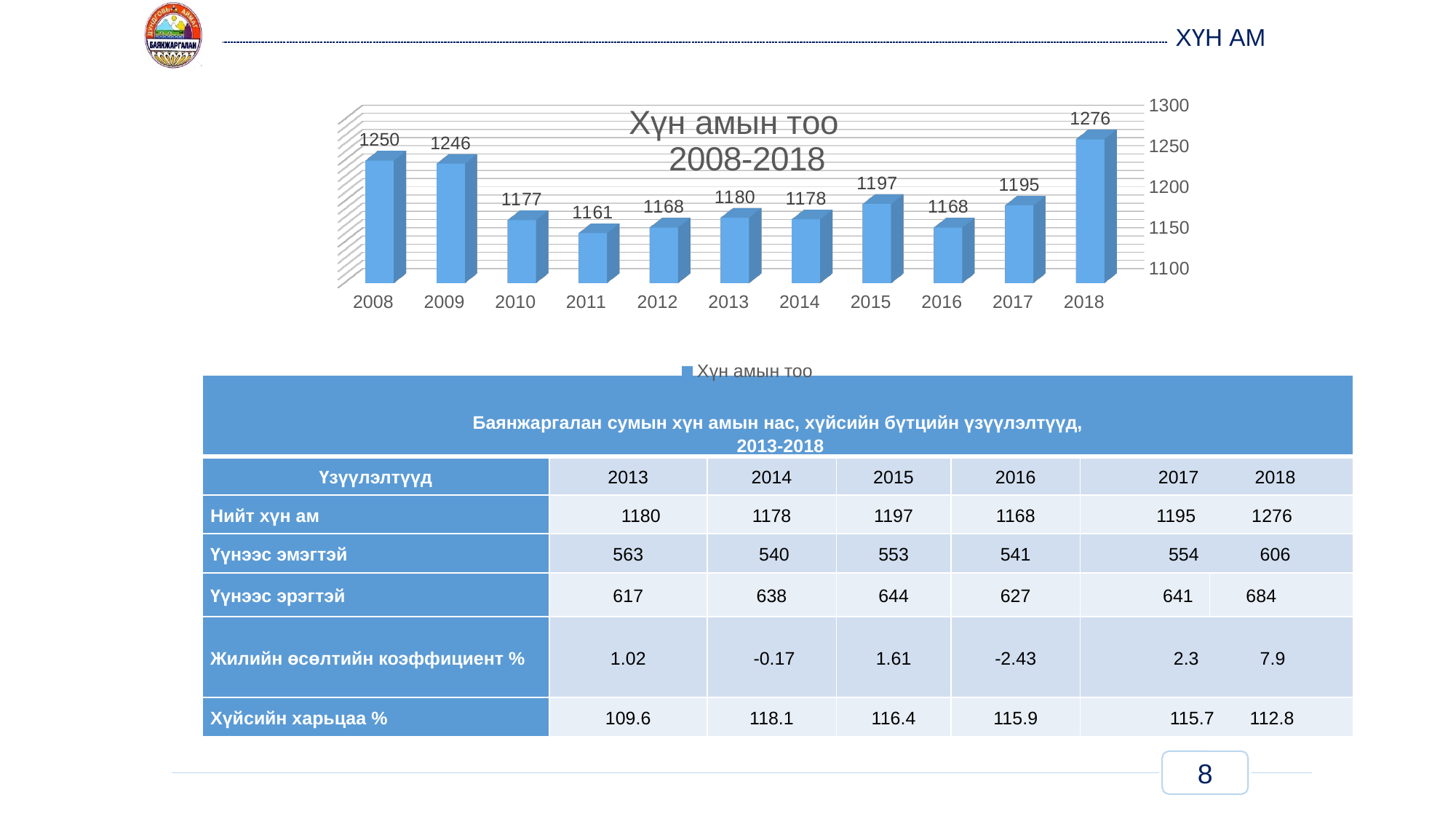
Which is larger in the chart, the value for 2013 or the value for 2016? 2013 What is the difference between the values for 2008 and 2010 in the chart? 73 Which year has the highest value in the chart? 2018 Is the value for 2017 in the chart greater or less than 1150? greater What is the value for 2015 in the chart? 1197 Which year has the lowest value in the chart? 2011 What is the value for 2011 in the chart? 1161 What is the value for 2008 in the chart? 1250 What is the difference between the values for 2018 and 2017 in the chart? 81 What is the title of the chart? Хүн амын тоо 2008-2018 What kind of chart is shown on the slide? bar chart How many years are shown on the x axis of the chart? 11